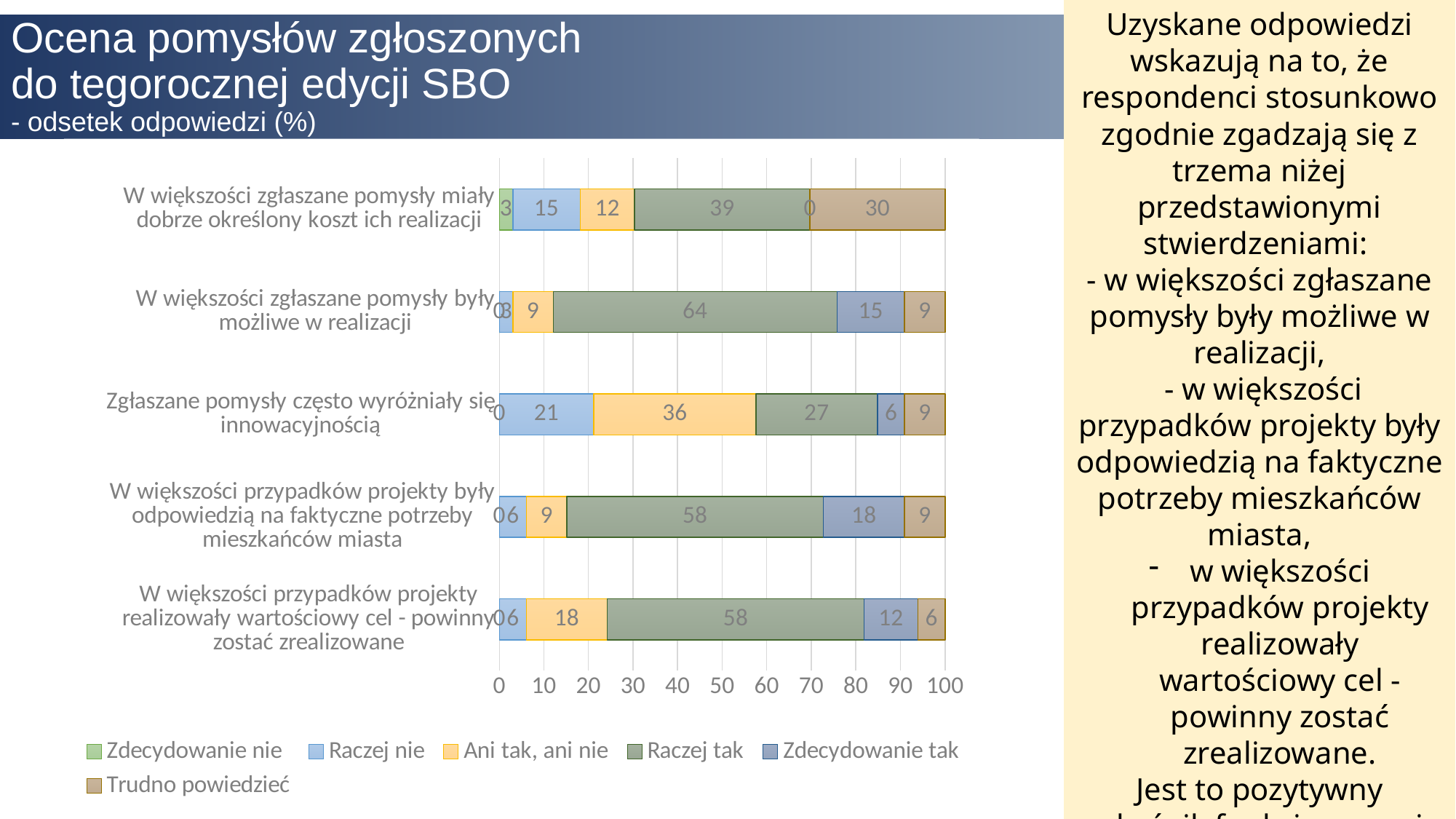
How many series does the legend list? 6 What is the difference between the 'Raczej tak' values for 'W większości zgłaszane pomysły były możliwe w realizacji' and 'Zgłaszane pomysły często wyróżniały się innowacyjnością'? 37 What is the 'Raczej tak' value for 'W większości zgłaszane pomysły były możliwe w realizacji'? 64 What is the first entry listed in the legend? Zdecydowanie nie Which statement has the highest 'Raczej tak' value? W większości zgłaszane pomysły były możliwe w realizacji What is the 'Ani tak, ani nie' value for 'Zgłaszane pomysły często wyróżniały się innowacyjnością'? 36 How many statements (categories) are plotted on the chart? 5 What kind of chart is shown on the slide? bar chart What is the 'Raczej nie' value for 'Zgłaszane pomysły często wyróżniały się innowacyjnością'? 21 What is the 'Trudno powiedzieć' value for 'W większości zgłaszane pomysły miały dobrze określony koszt ich realizacji'? 30 Which has the larger 'Zdecydowanie tak' value: 'W większości przypadków projekty były odpowiedzią na faktyczne potrzeby mieszkańców miasta' or 'W większości zgłaszane pomysły były możliwe w realizacji'? W większości przypadków projekty były odpowiedzią na faktyczne potrzeby mieszkańców miasta Which statement has the lowest 'Raczej tak' value? Zgłaszane pomysły często wyróżniały się innowacyjnością